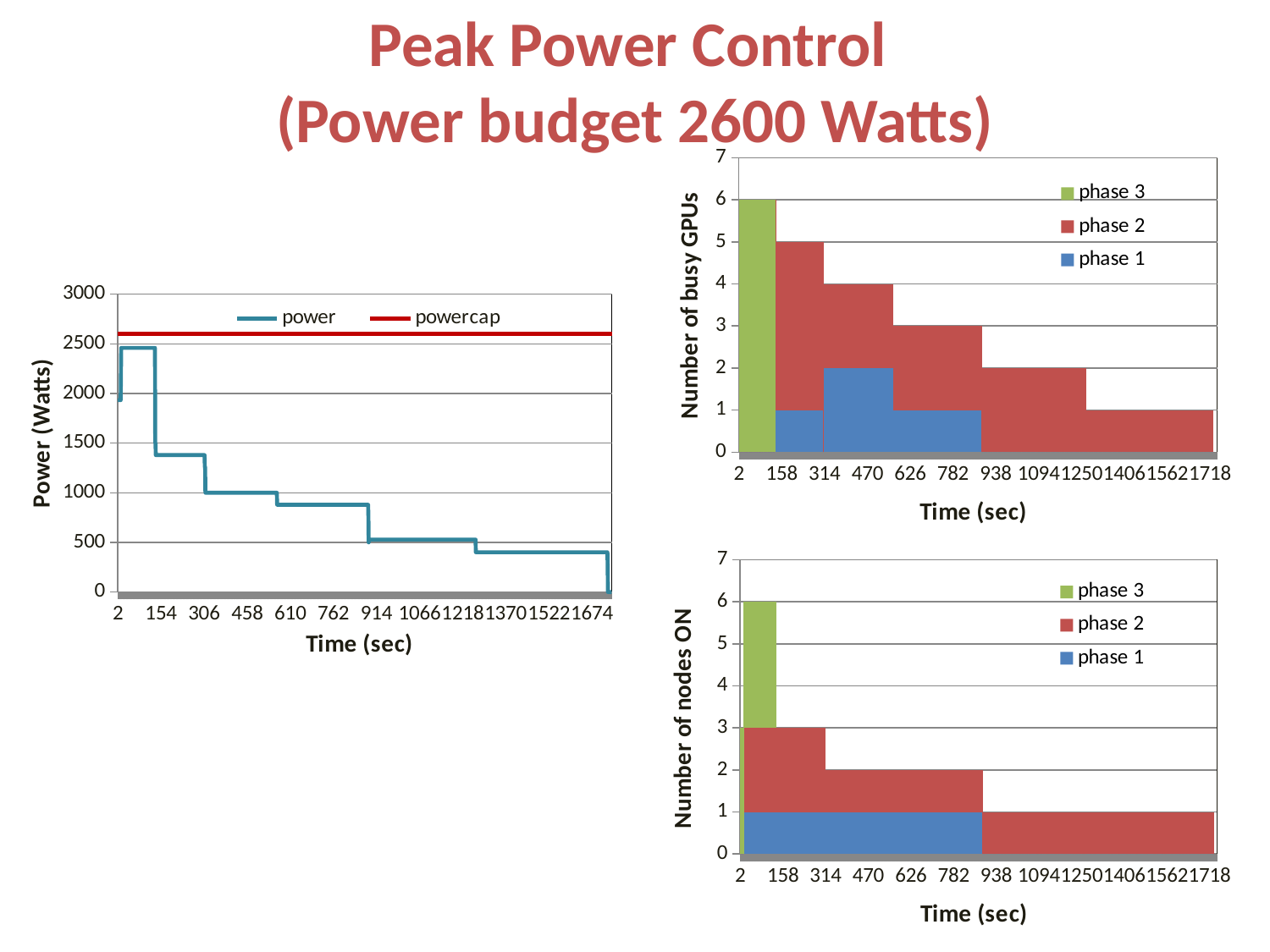
In the bottom-right Number of nodes ON chart, what is the phase 1 value at time 158? 1 In the top-right Number of busy GPUs chart, at which time is the total number of busy GPUs highest? 2 In the left Power (Watts) chart, does the power series rise or fall over time after its initial peak? fall What kind of chart is the left chart showing Power (Watts) against Time (sec)? line chart In the left Power (Watts) chart, is the power value at time 154 greater or less than 1000? greater How many series does the legend of the left Power (Watts) chart list? 2 In the left Power (Watts) chart, which series is higher throughout, power or powercap? powercap How many series does the legend of the top-right Number of busy GPUs chart list? 3 According to the slide title, what is the power budget? 2600 Watts In the top-right Number of busy GPUs chart, what is the total number of busy GPUs at time 2? 6 In the left Power (Watts) chart, is the power value at time 762 greater or less than 1000? less